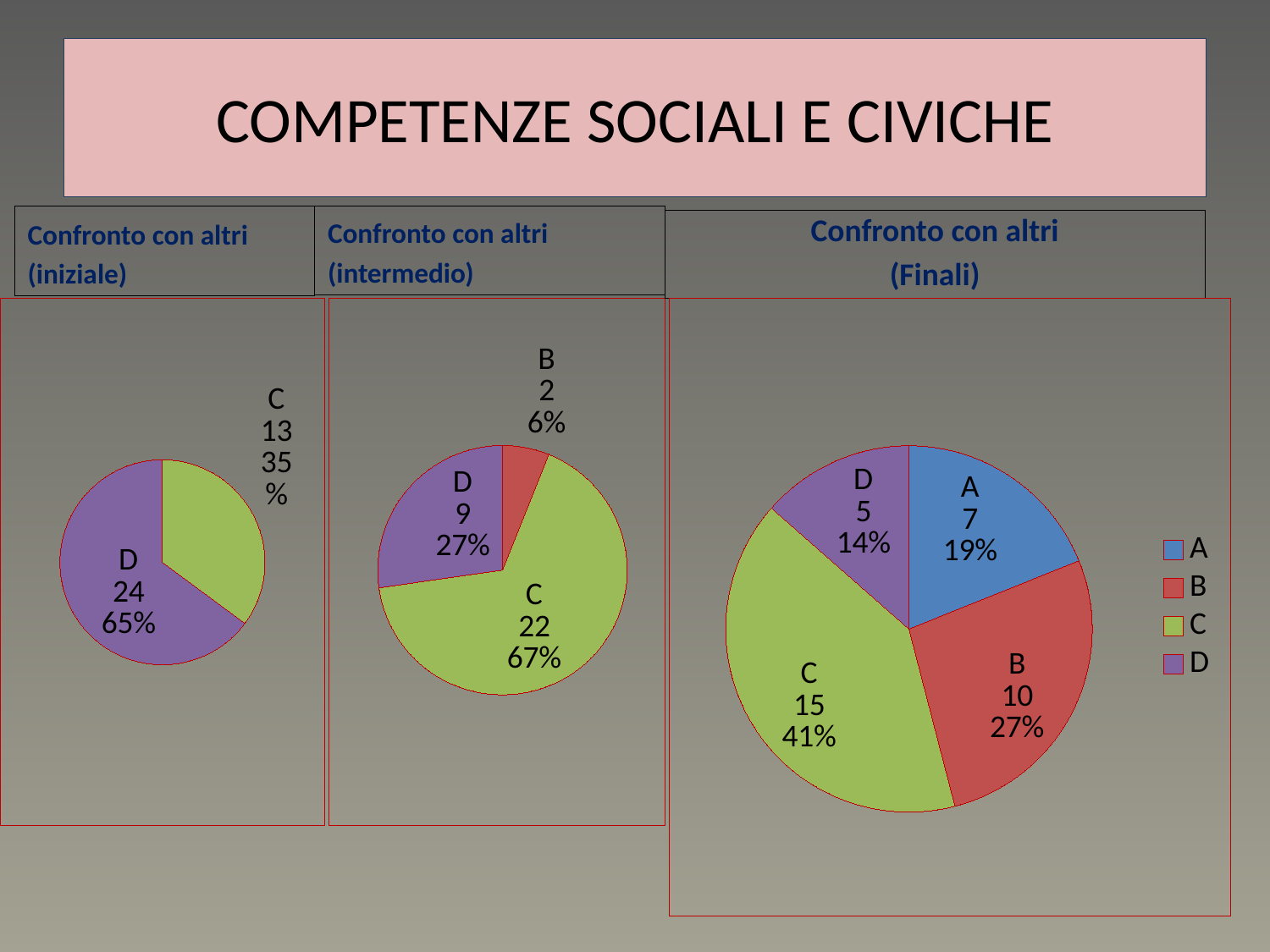
In the 'Confronto con altri (intermedio)' chart, what percentage is shown for B? 6% In the 'Confronto con altri (intermedio)' chart, what is the value for C? 22 In the 'Confronto con altri (iniziale)' chart, what is the value for D? 24 In the 'Confronto con altri (Finali)' chart, which is larger, the value for A or the value for B? B In the 'Confronto con altri (Finali)' chart, which category has the largest slice? C In the 'Confronto con altri (Finali)' chart, what is the difference between the values for B and D? 5 In the 'Confronto con altri (iniziale)' chart, what share of the pie does C represent? 35% How many entries does the legend next to the 'Confronto con altri (Finali)' chart list? 4 What kind of chart is used in the 'Confronto con altri (Finali)' panel? Pie chart In the 'Confronto con altri (Finali)' chart, what is the value for A? 7 How many categories are shown in the 'Confronto con altri (Finali)' chart? 4 In the 'Confronto con altri (intermedio)' chart, which category has the smallest slice? B